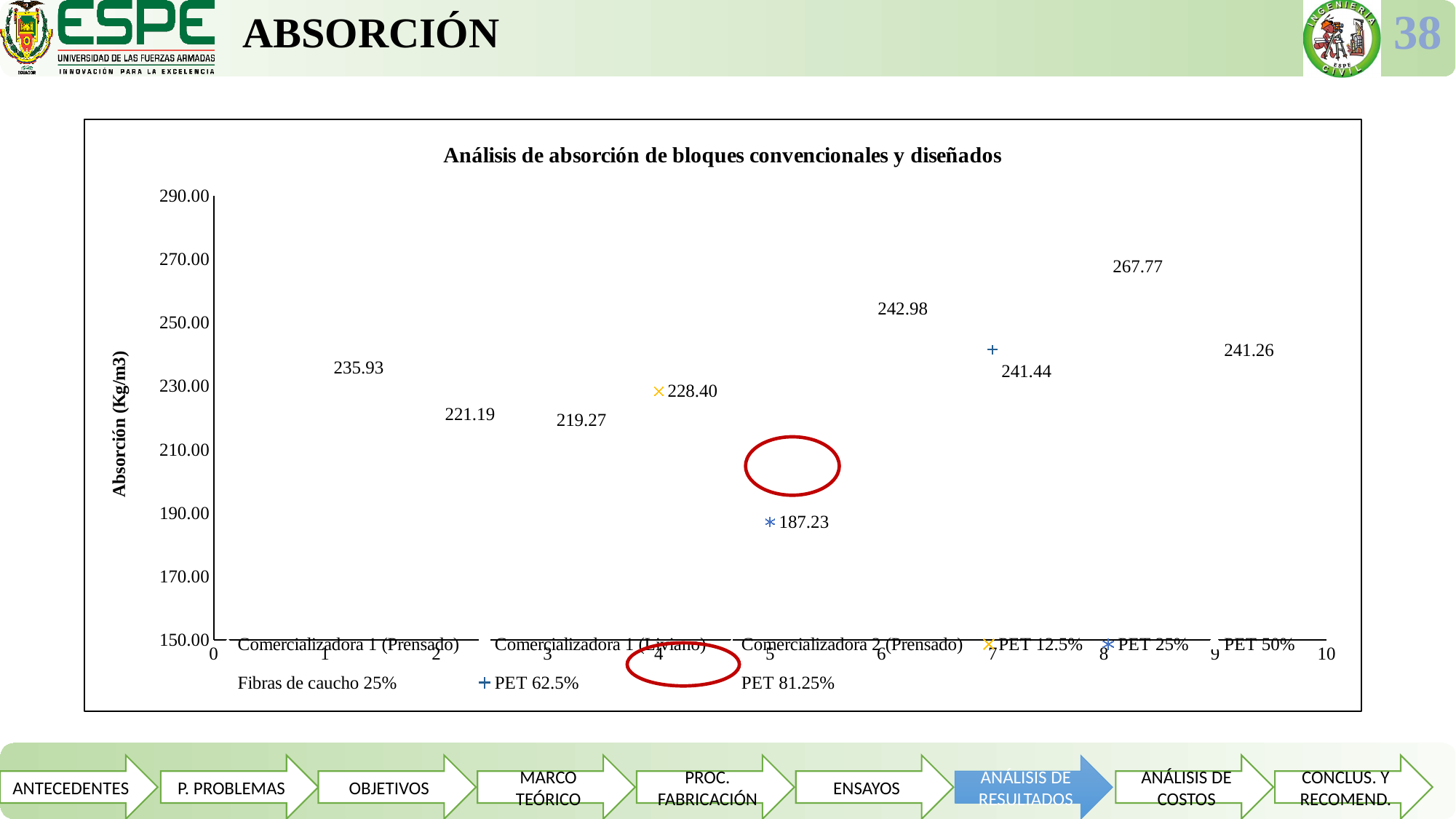
What is the lowest absorption value labelled on the chart? 187.23 What kind of chart is shown on the slide? scatter chart What is the label of the vertical axis? Absorción (Kg/m3) What is the absorption value labelled for PET 62.5%? 241.44 How many series does the chart legend list? 9 What is the absorption value labelled for PET 25%? 187.23 What is the absorption value labelled for PET 12.5%? 228.40 What is the highest absorption value labelled on the chart? 267.77 What is the title of the chart? Análisis de absorción de bloques convencionales y diseñados Is the value for PET 25% greater or less than 190.00? less What is the difference between the values for PET 62.5% and PET 12.5%? 13.04 Which has the larger absorption value, PET 62.5% or PET 12.5%? PET 62.5%